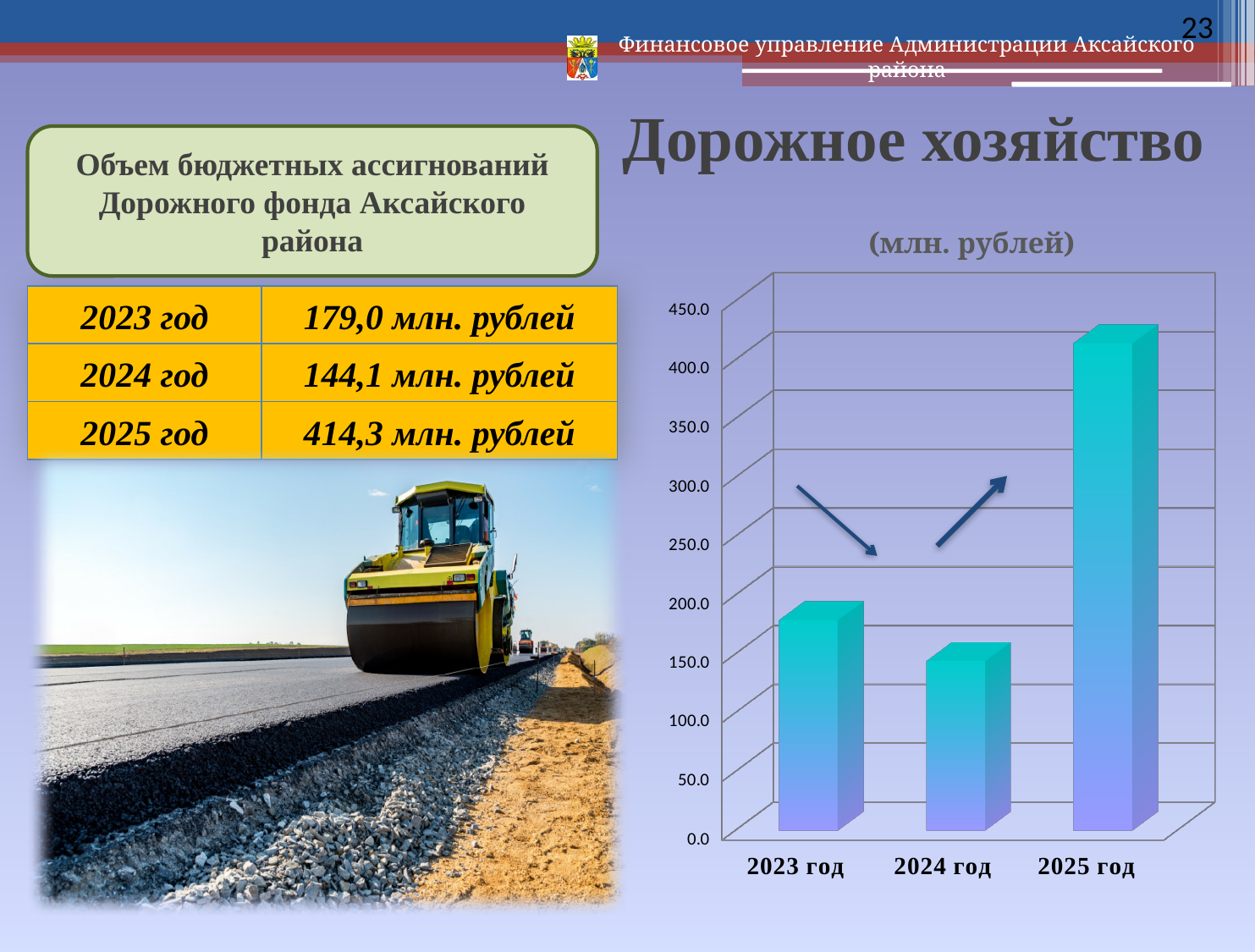
Is the value for 2025 год greater or less than 400.0? greater Is the value for 2024 год greater or less than 150.0? less Which year has the lowest value in the chart? 2024 год Is the value for 2023 год greater or less than 200.0? less Which is larger, the value for 2023 год or the value for 2024 год? 2023 год What unit is stated above the chart? млн. рублей How many bars (years) does the chart show? 3 Which year has the highest value in the chart? 2025 год What kind of chart is shown on the slide? bar chart According to the slide, what is the volume of budget allocations of the Road Fund for 2024 год? 144,1 млн. рублей By how much does the 2025 год value exceed the 2023 год value, using the figures printed on the slide? 235,3 млн. рублей According to the slide, what is the volume of budget allocations of the Road Fund for 2025 год? 414,3 млн. рублей